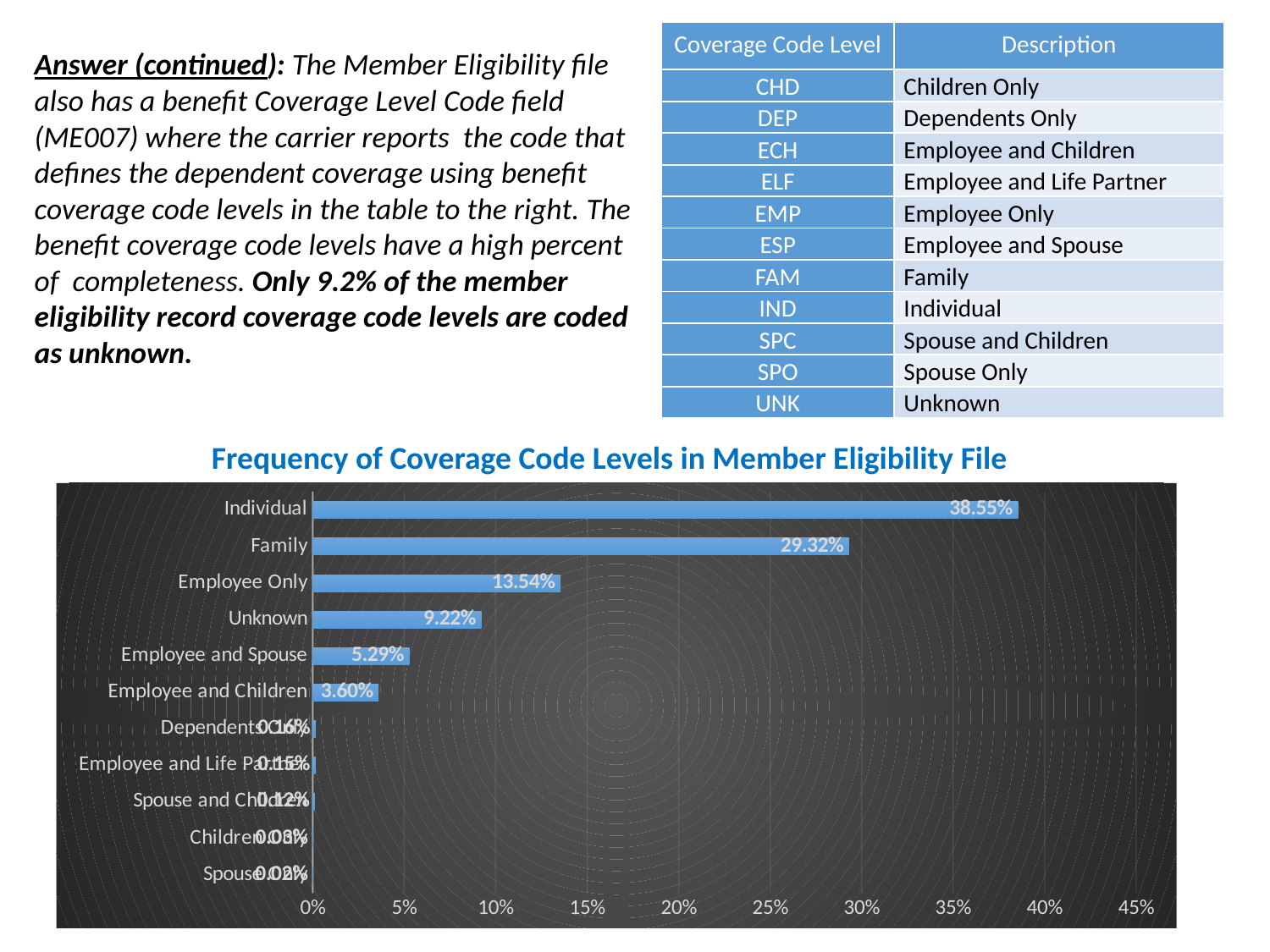
What is the value for Employee and Children? 3.60% What is the value for Family? 29.32% What type of chart is shown on the slide? bar chart Which is larger, the value for Employee Only or the value for Unknown? Employee Only What is the title of the chart? Frequency of Coverage Code Levels in Member Eligibility File What is the difference between the values for Individual and Family? 9.23% What is the value for Individual? 38.55% What is the value for Employee Only? 13.54% What is the value for Employee and Spouse? 5.29% Which coverage code level has the highest frequency? Individual What is the value for Unknown? 9.22% How many coverage code level categories are plotted in the chart? 11